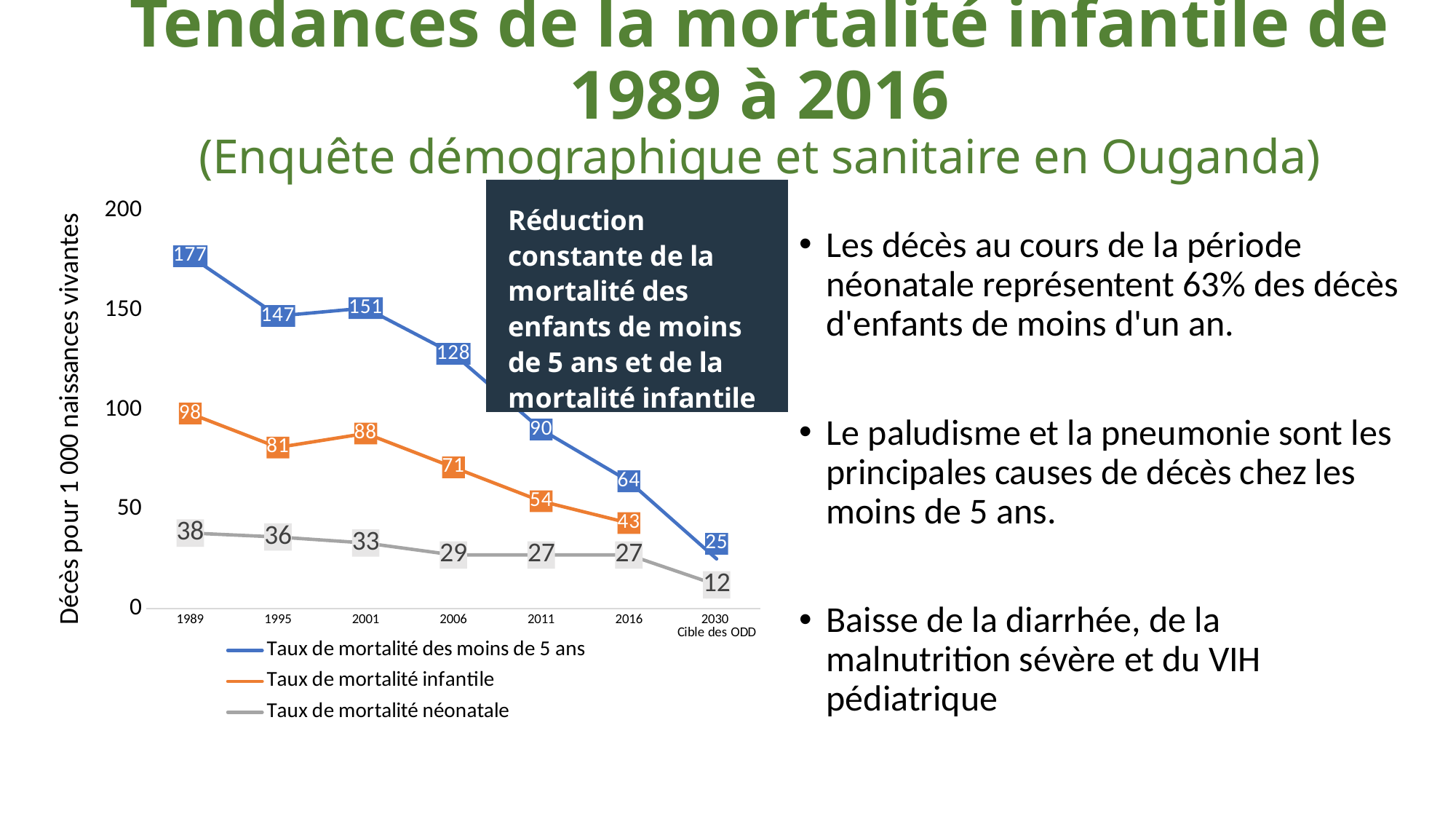
What is the value of 'Taux de mortalité néonatale' in 2030 (Cible des ODD)? 12 What is the difference between 'Taux de mortalité des moins de 5 ans' in 1989 and in 2016? 113 How many series does the chart legend list? 3 Does 'Taux de mortalité infantile' generally rise or fall from 1989 to 2016? fall What is the value of 'Taux de mortalité des moins de 5 ans' in 1989? 177 How many years are shown on the x axis of the chart? 7 What type of chart is shown on the slide? line chart Which is larger in 2001: 'Taux de mortalité infantile' or 'Taux de mortalité néonatale'? Taux de mortalité infantile What is the label of the vertical axis of the chart? Décès pour 1 000 naissances vivantes In which year is 'Taux de mortalité néonatale' at its lowest? 2030 What is the value of 'Taux de mortalité infantile' in 2011? 54 In which year is 'Taux de mortalité des moins de 5 ans' at its highest? 1989